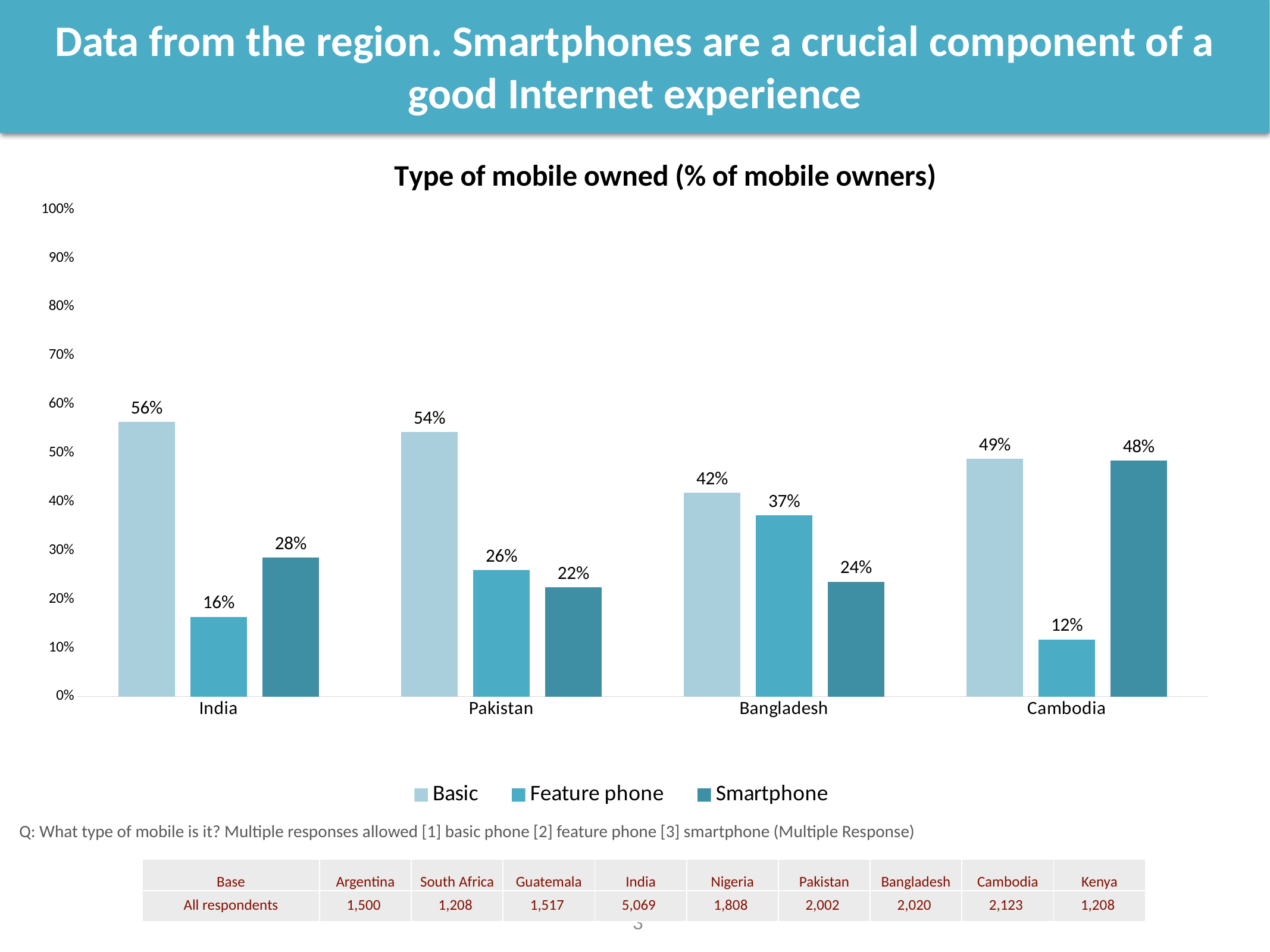
What kind of chart is shown on the slide? Bar chart Which is larger for Pakistan: the Feature phone value or the Smartphone value? Feature phone Which country has the highest Basic value? India What is the Feature phone value for Bangladesh? 37% What is the Basic value for Pakistan? 54% Which country has the lowest Feature phone value? Cambodia What is the title of the chart? Type of mobile owned (% of mobile owners) Which country has the highest Smartphone value? Cambodia What is the difference between the Basic and Smartphone values for India? 28% What is the Smartphone value for Cambodia? 48% How many series does the legend list? 3 How many countries are shown on the x axis of the chart? 4